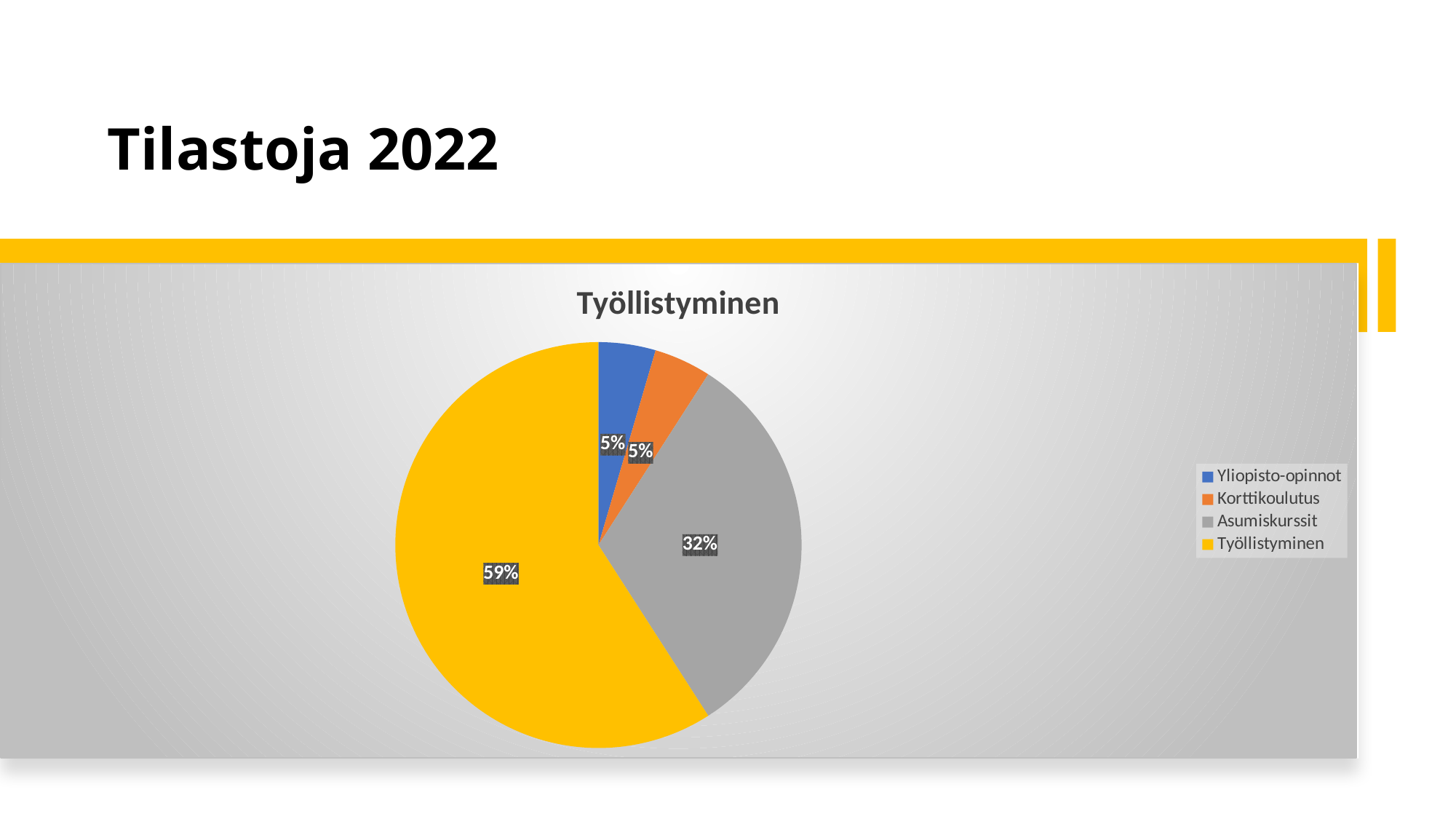
Is the share for Asumiskurssit greater or less than 50%? less What type of chart is shown on the slide? pie chart Which colour represents Asumiskurssit in the chart? grey What share of the pie does Asumiskurssit have? 32% Which category has the largest slice of the pie? Työllistyminen What is the difference in percentage points between Työllistyminen and Asumiskurssit? 27 What is the title of the chart? Työllistyminen What share of the pie does Korttikoulutus have? 5% Which is larger, the slice for Asumiskurssit or the slice for Korttikoulutus? Asumiskurssit How many categories does the legend list? 4 What share of the pie does Yliopisto-opinnot have? 5%